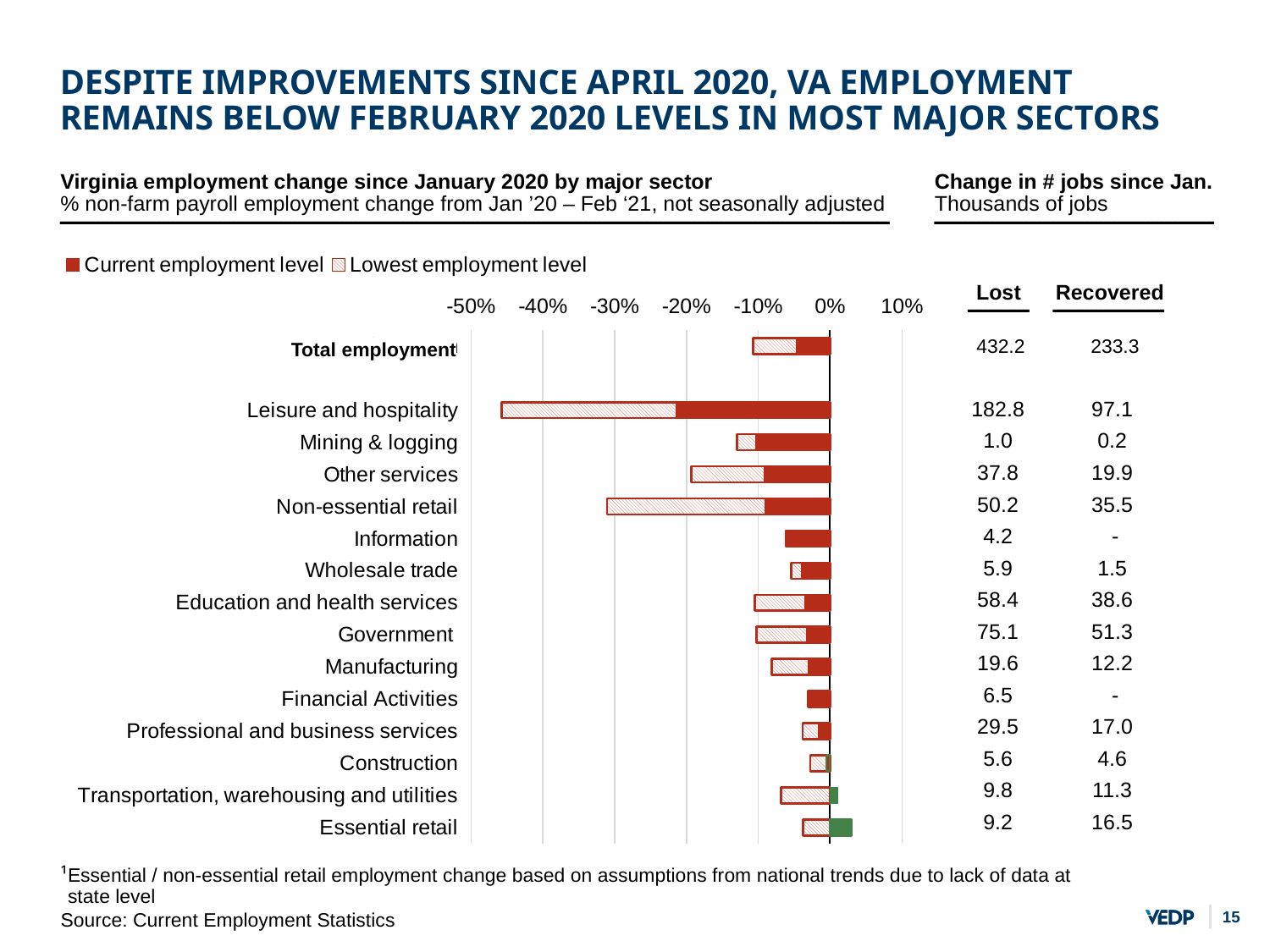
How many series does the legend of the employment change chart list? 2 Which sector shows the highest (most positive) current employment level in the chart? Essential retail In the 'Change in # jobs since Jan.' table, which sector lost more jobs: Government or Education and health services? Government How many sector categories (excluding Total employment) are plotted in the employment change chart? 14 What are the two series named in the legend of the employment change chart? Current employment level and Lowest employment level In the 'Change in # jobs since Jan.' table, what is the difference between jobs lost and jobs recovered for Total employment (in thousands)? 198.9 Which sector shows the largest decline in current employment level in the chart? Leisure and hospitality In the 'Change in # jobs since Jan.' table, how many thousand jobs were lost in Leisure and hospitality? 182.8 What kind of chart is used to show Virginia employment change since January 2020 by major sector? Bar chart Is the current employment level for Information greater or less than -10%? greater Is the lowest employment level for Leisure and hospitality greater or less than -40%? less In the 'Change in # jobs since Jan.' table, how many thousand jobs were recovered in Government? 51.3